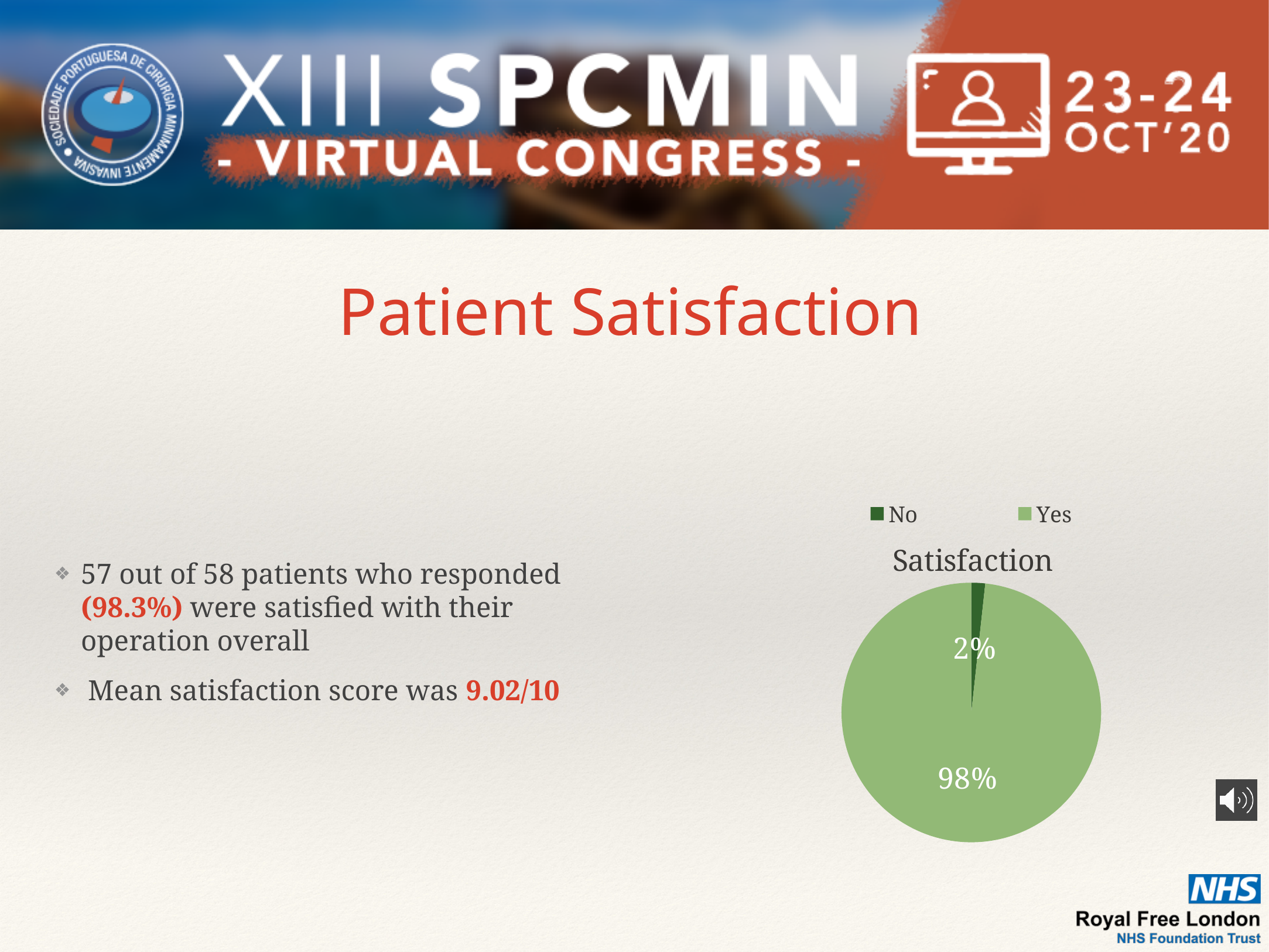
What colour is the Yes slice in the pie chart? light green What is the difference in percentage points between the Yes and No slices? 96% What share of the pie does the Yes slice represent? 98% How many slices does the pie chart have? 2 What share of the pie does the No slice represent? 2% What kind of chart is shown on the slide? pie chart What is the title of the chart? Satisfaction Which slice of the pie is the smallest? No Which slice of the pie is the largest? Yes Which is larger, the Yes slice or the No slice? Yes How many entries does the legend list? 2